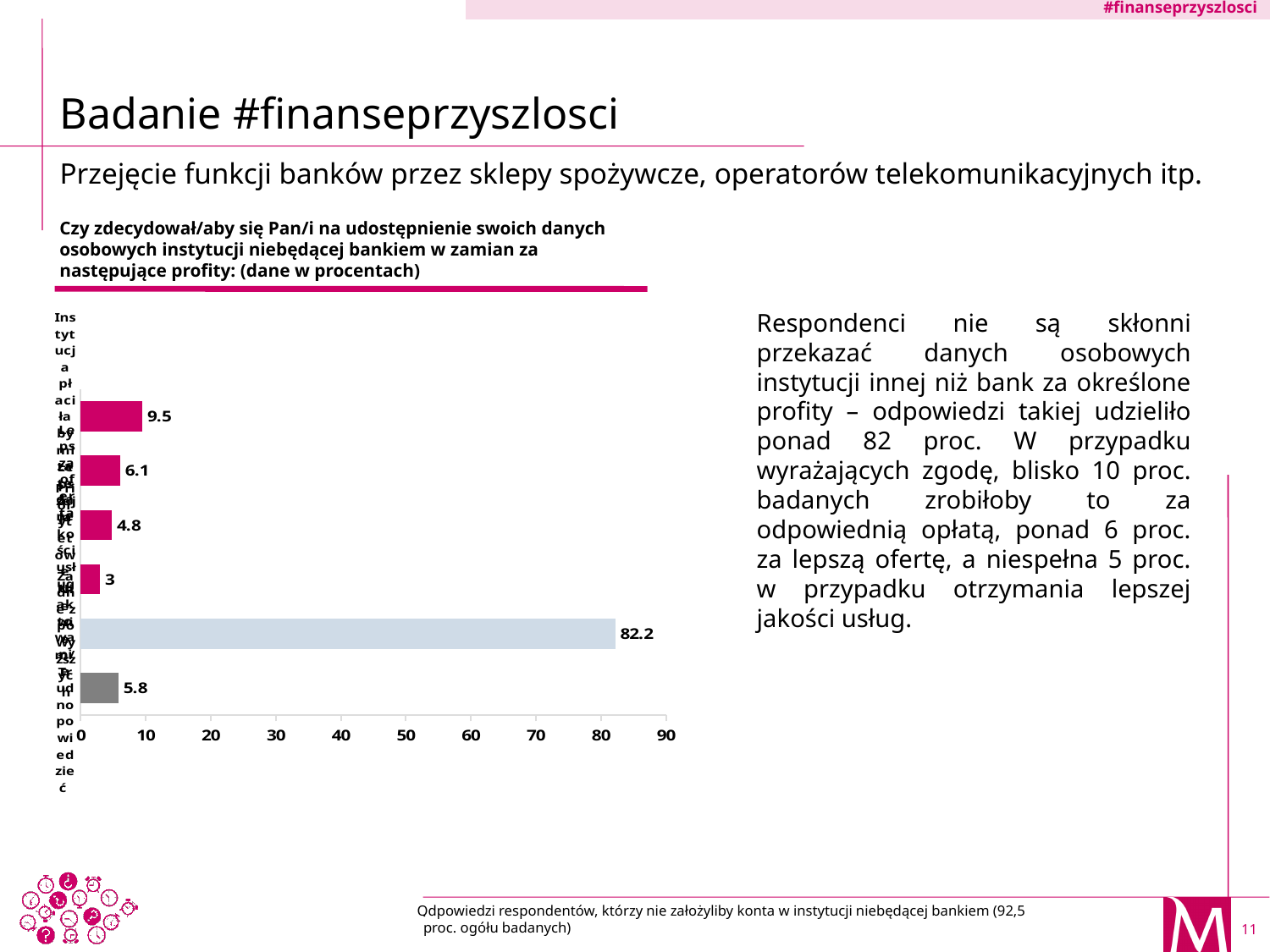
How many bars does the chart contain? 6 Which is larger: the second bar from the top (6.1) or the bottom grey bar (5.8)? the second bar from the top (6.1) What is the difference between the longest bar (82.2) and the topmost bar (9.5)? 72.7 Is the value of the light blue bar greater or less than 80? greater What is the difference between the third bar from the top (4.8) and the fourth bar from the top (3)? 1.8 What is the value of the longest bar in the chart? 82.2 What is the value of the topmost bar in the chart? 9.5 What is the value of the bottom (grey) bar in the chart? 5.8 What is the value of the light blue bar in the chart? 82.2 What is the highest value shown on the horizontal axis? 90 What is the value of the shortest bar in the chart? 3 What kind of chart is shown on the slide? bar chart